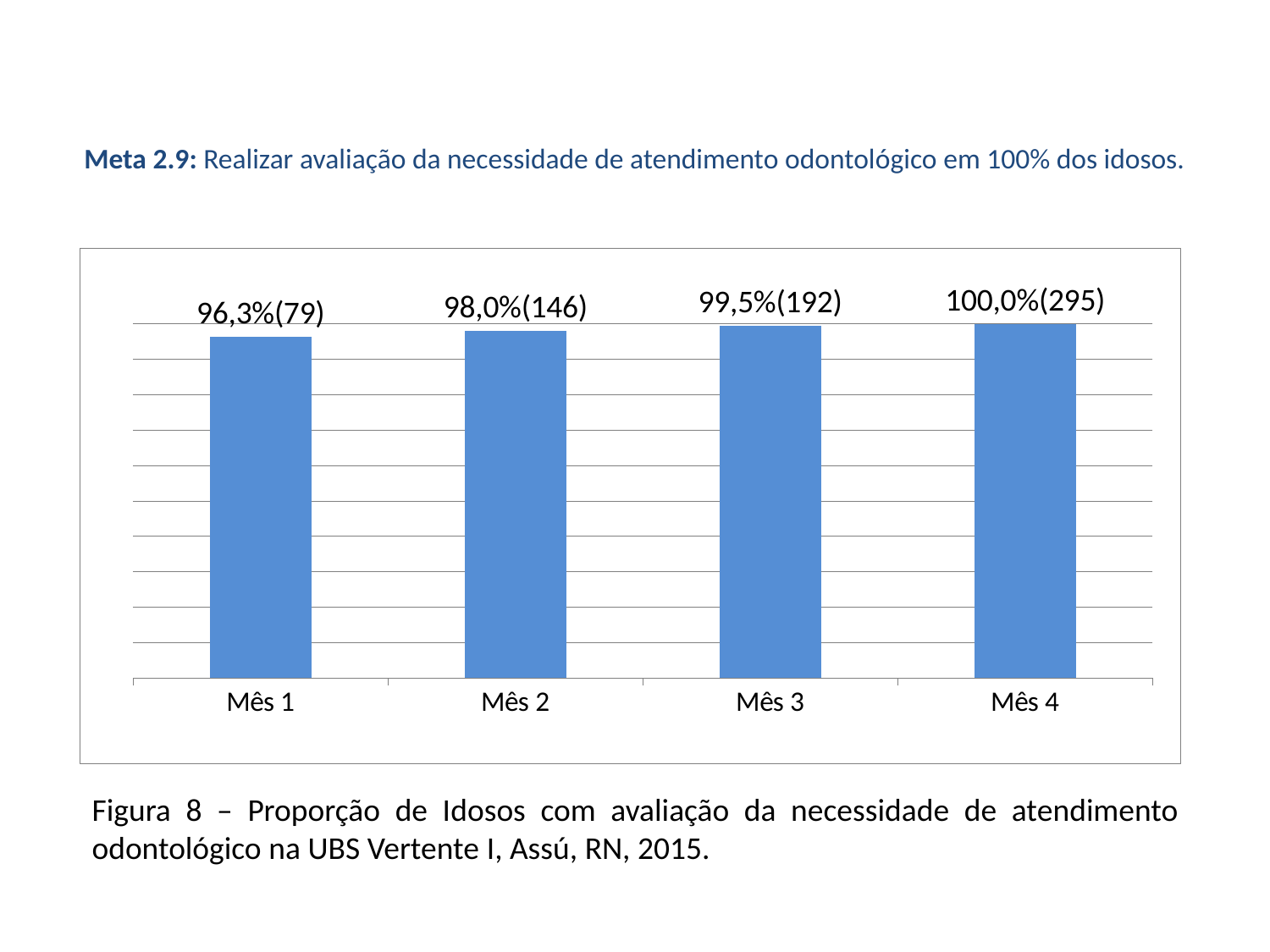
What kind of chart is shown? Bar chart What is the difference in percentage points between Mês 4 and Mês 1? 3,7 What count is shown in parentheses for Mês 2? 146 Which month has the highest value? Mês 4 Do the values rise or fall from Mês 1 to Mês 4? Rise What is the difference between the counts in parentheses for Mês 4 and Mês 3? 103 What percentage is shown for Mês 4? 100,0% What is the data label shown for Mês 3? 99,5%(192) Which month has the lowest value? Mês 1 How many months are shown on the x axis? 4 Which is larger, the value for Mês 2 or the value for Mês 3? Mês 3 What is the data label shown for Mês 1? 96,3%(79)